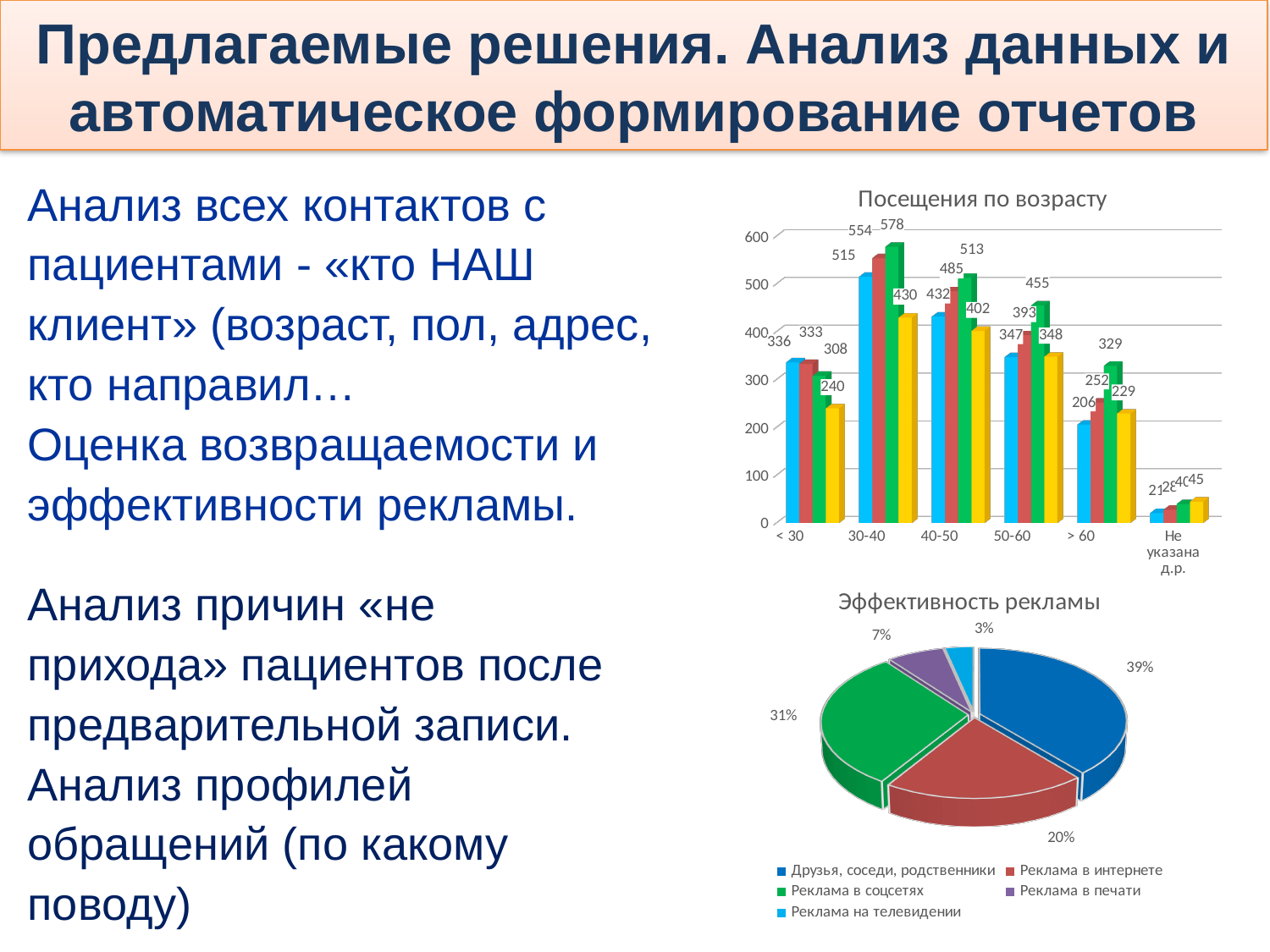
In the pie chart 'Эффективность рекламы', what share is shown for 'Реклама в соцсетях'? 31% What kind of chart is 'Посещения по возрасту'? Bar chart In the pie chart 'Эффективность рекламы', what share is shown for 'Друзья, соседи, родственники'? 39% In the pie chart 'Эффективность рекламы', how many percentage points larger is 'Реклама в интернете' than 'Реклама в печати'? 13 In the chart 'Посещения по возрасту', what is the highest labeled value in the '30-40' group? 578 In the chart 'Посещения по возрасту', what is the lowest labeled value in the '> 60' group? 206 How many age categories are shown on the x axis of the chart 'Посещения по возрасту'? 6 In the pie chart 'Эффективность рекламы', which category has the largest slice? Друзья, соседи, родственники In the pie chart 'Эффективность рекламы', which category has the smallest slice? Реклама на телевидении In the pie chart 'Эффективность рекламы', what share is shown for 'Реклама на телевидении'? 3% In the chart 'Посещения по возрасту', which age group contains the tallest bar? 30-40 How many entries does the legend of the pie chart 'Эффективность рекламы' list? 5